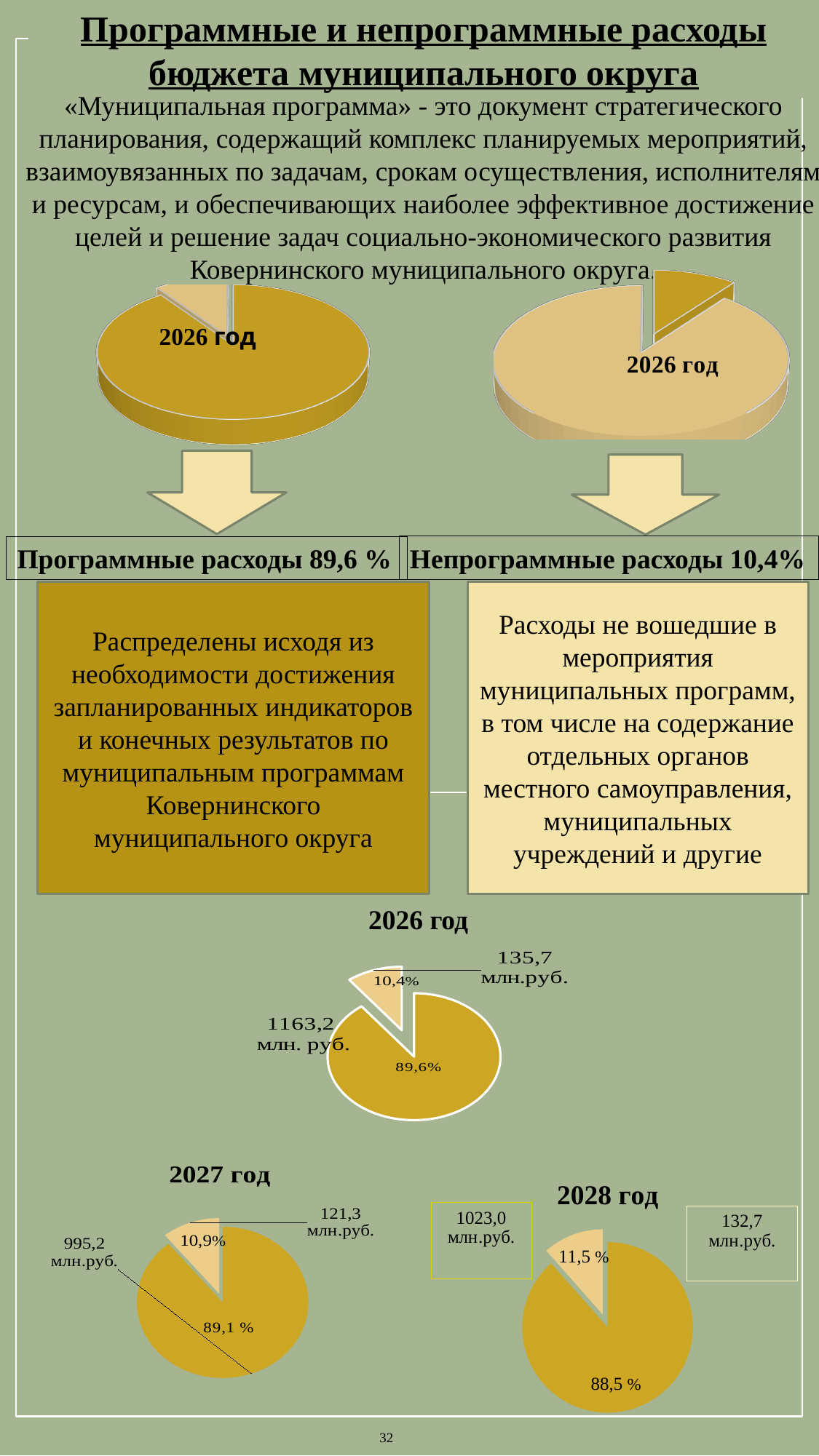
How many slices does the pie chart titled "2027 год" have? 2 In the pie chart titled "2026 год" at the bottom of the slide, what value in млн. руб. is shown for the larger slice? 1163,2 млн. руб. In the pie chart titled "2027 год", what percentage share does the larger slice have? 89,1 % Which is larger: the smaller slice of the "2027 год" pie chart (121,3 млн.руб.) or the smaller slice of the "2028 год" pie chart (132,7 млн.руб.)? 2028 год (132,7 млн.руб.) What is the total of the two slice values in the pie chart titled "2028 год", in млн.руб.? 1155,7 In the pie chart titled "2026 год" at the bottom of the slide, what percentage is shown for the smaller slice? 10,4% What kind of chart is used for the "2028 год" chart? Pie chart In the pie chart titled "2027 год", what value is shown for the smaller slice? 121,3 млн.руб. In the pie chart titled "2028 год", what value is shown for the larger slice? 1023,0 млн.руб. Which of the three bottom pie charts (2026, 2027, 2028 год) has the largest value for its larger slice? 2026 год In the pie chart titled "2026 год" at the bottom of the slide, what is the difference between the two slice values in млн. руб.? 1027,5 In the pie chart titled "2028 год", what percentage is shown for the smaller slice? 11,5 %